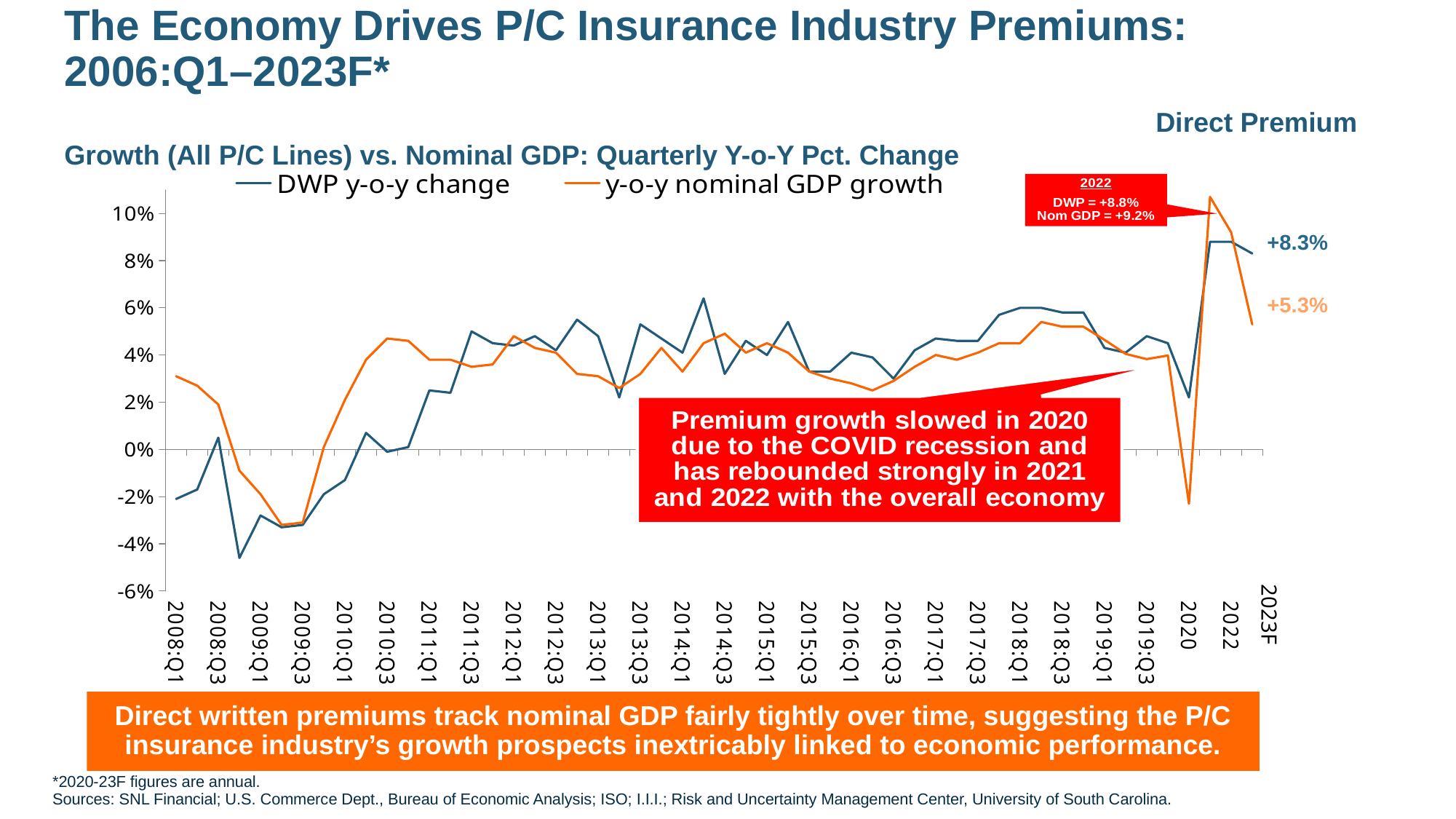
How many series does the chart legend list? 2 Does y-o-y nominal GDP growth rise or fall from 2022 to 2023F? Fall What is the y-o-y nominal GDP growth value labeled for 2023F? +5.3% What kind of chart is shown on the slide? Line chart What was the DWP y-o-y change in 2022 according to the callout? +8.8% In 2023F, which is larger: DWP y-o-y change or nominal GDP growth? DWP y-o-y change What was nominal GDP growth in 2022 according to the callout? +9.2% In 2023F, how many percentage points higher is the DWP y-o-y change than nominal GDP growth? 3.0 percentage points What is the DWP y-o-y change value labeled for 2023F? +8.3% Is the y-o-y nominal GDP growth value for 2020 greater or less than 0%? less Which colour is used for the y-o-y nominal GDP growth line? Orange In 2022, which was larger: DWP y-o-y change or nominal GDP growth? Nominal GDP growth